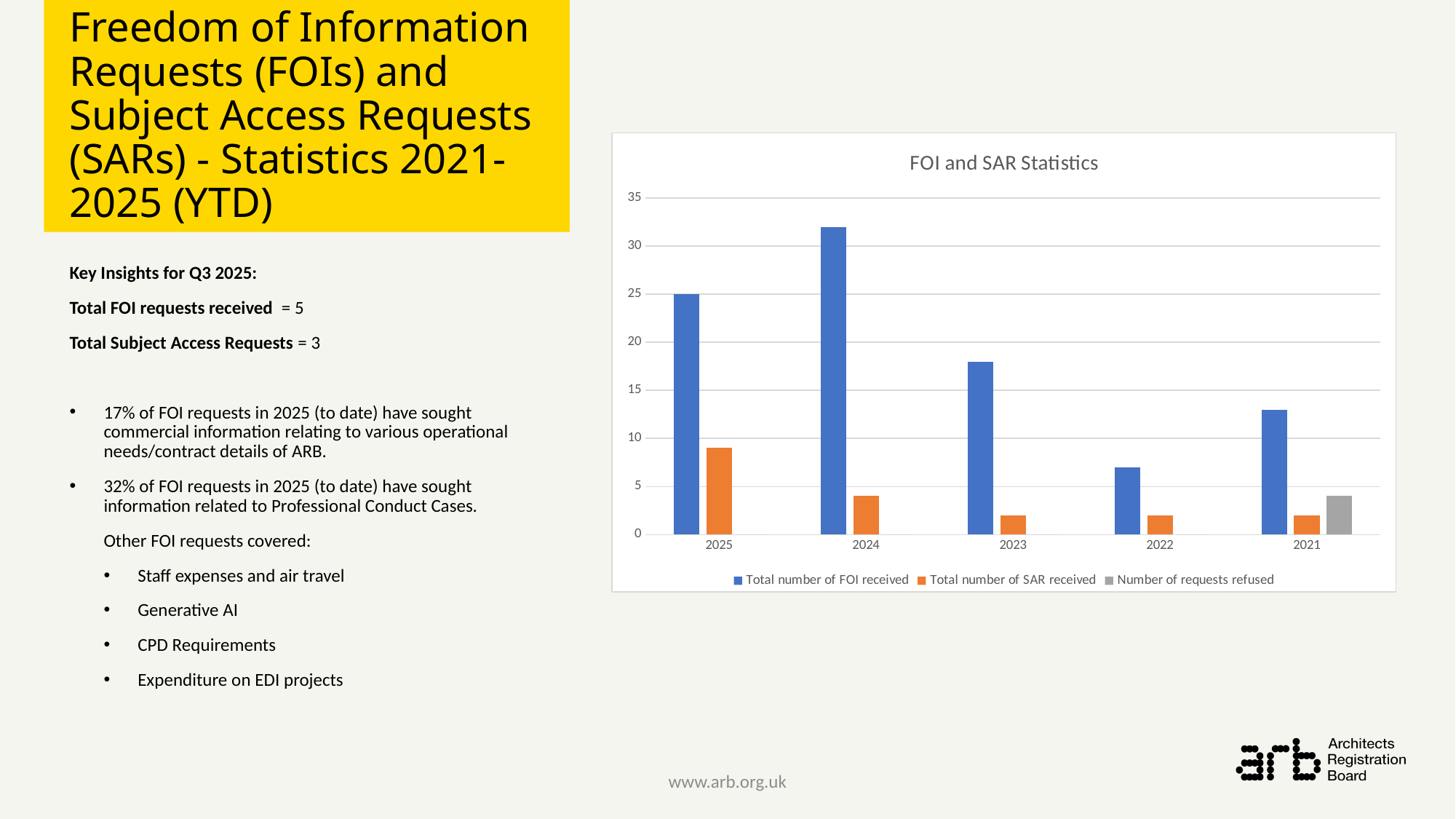
Which year has the highest total number of SAR received? 2025 Is the total number of FOI received in 2024 greater or less than 30? greater How many series does the legend of the chart list? 3 Is the total number of FOI received in 2023 greater or less than 20? less What kind of chart is shown on the slide? bar chart What is the title of the chart? FOI and SAR Statistics In which year does the chart show a bar for the number of requests refused? 2021 Which is larger: the total number of SAR received in 2025 or in 2024? 2025 Is the total number of FOI received in 2022 greater or less than 10? less Which year has the lowest total number of FOI received? 2022 How many years are shown on the x axis of the chart? 5 Which year has the highest total number of FOI received? 2024